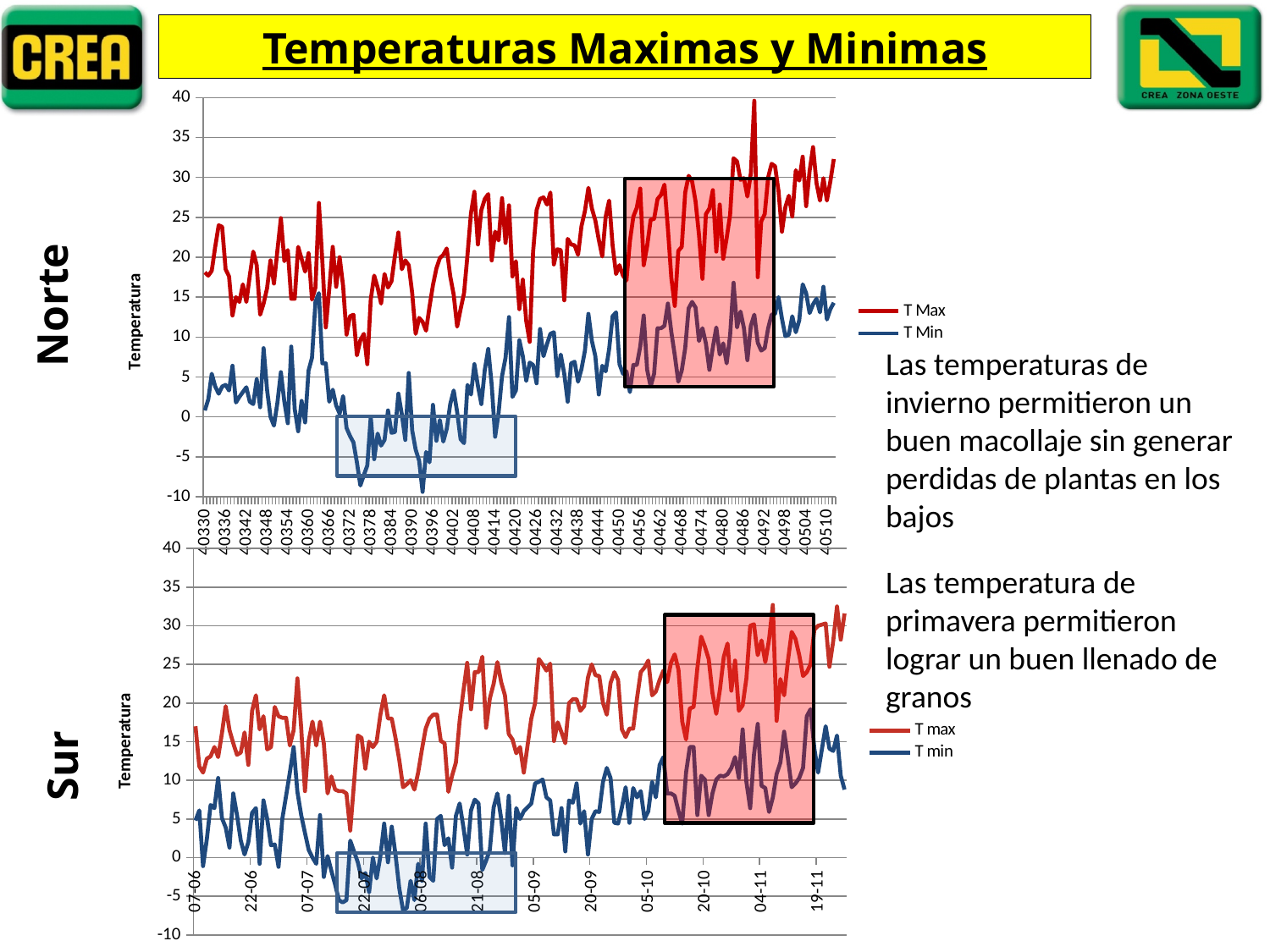
What is the maximum value shown on the vertical axis of the Norte chart? 40 What are the two series named in the legend of the Sur chart? T max and T min In the Sur chart, is the lowest value of the T min series greater or less than 0? less In the Norte chart, is the highest value of the T Max series greater or less than 35? greater In the Norte chart, does the T Min series generally rise or fall from left to right along the x axis? rise What is the label on the vertical axis of the Sur chart? Temperatura What kind of chart is the Norte chart at the top of the slide? line chart In the Sur chart, does the T max series generally rise or fall from left to right along the x axis? rise In the Norte chart, is the lowest value of the T Min series greater or less than -5? less How many series does the legend of the Norte chart list? 2 In the Norte chart, which series has the higher values throughout, T Max or T Min? T Max